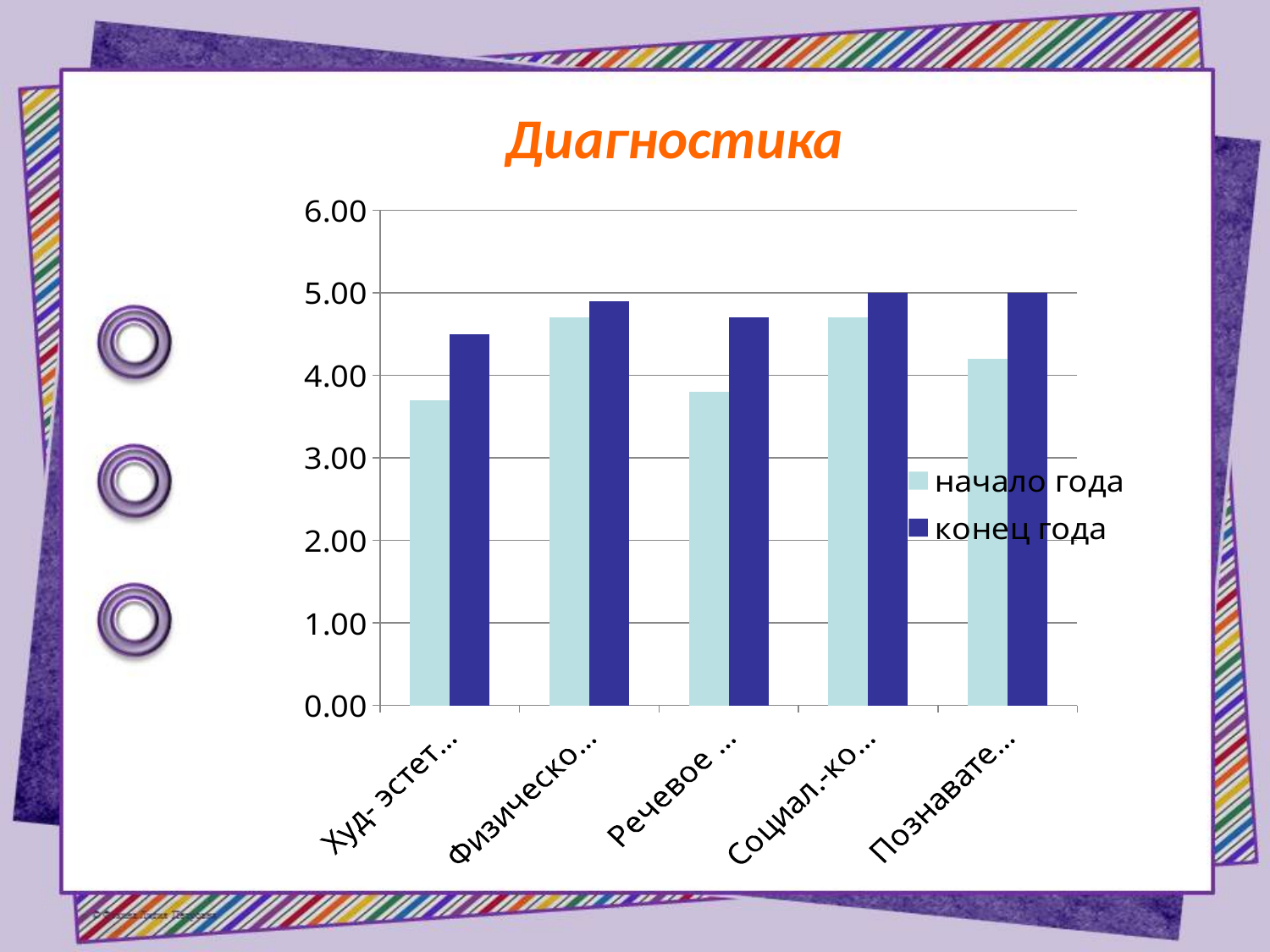
Is the value of начало года for Речевое ... greater or less than 4.00? less What is the value of конец года for Социал.-ко...? 5.00 Which has the larger начало года value: Физическо... or Худ- эстет...? Физическо... How many series does the legend list? 2 What is the value of конец года for Познавате...? 5.00 What are the two legend entries of the chart? начало года, конец года How many categories are shown on the x axis? 5 For Худ- эстет..., which is larger: начало года or конец года? конец года What kind of chart is shown on the slide? bar chart Is the value of конец года for Худ- эстет... greater or less than 4.00? greater Is the value of начало года for Худ- эстет... greater or less than 4.00? less What is the title of the slide above the chart? Диагностика